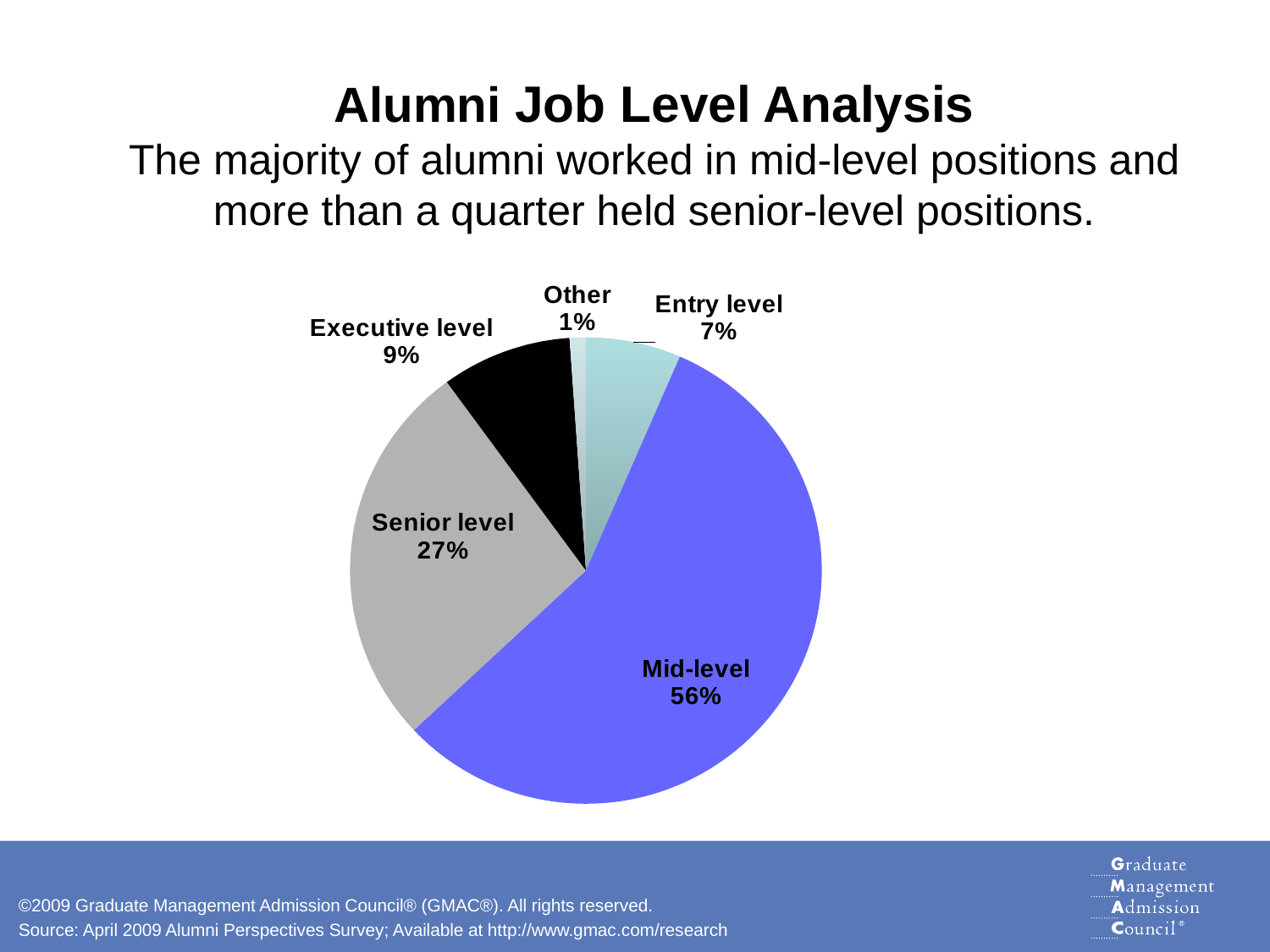
What percentage is shown for Entry level? 7% What percentage of alumni worked in mid-level positions? 56% What is the difference in percentage points between Mid-level and Senior level? 29 Which job level has the largest share of the pie? Mid-level What percentage of alumni held senior-level positions? 27% What kind of chart is shown on the slide? Pie chart Which is larger, the Executive level share or the Entry level share? Executive level What percentage is shown for the Other slice? 1% How many slices does the pie chart have? 5 What is the title of the slide containing the pie chart? Alumni Job Level Analysis What share of the pie is labelled Executive level? 9% Which job level has the smallest share of the pie? Other